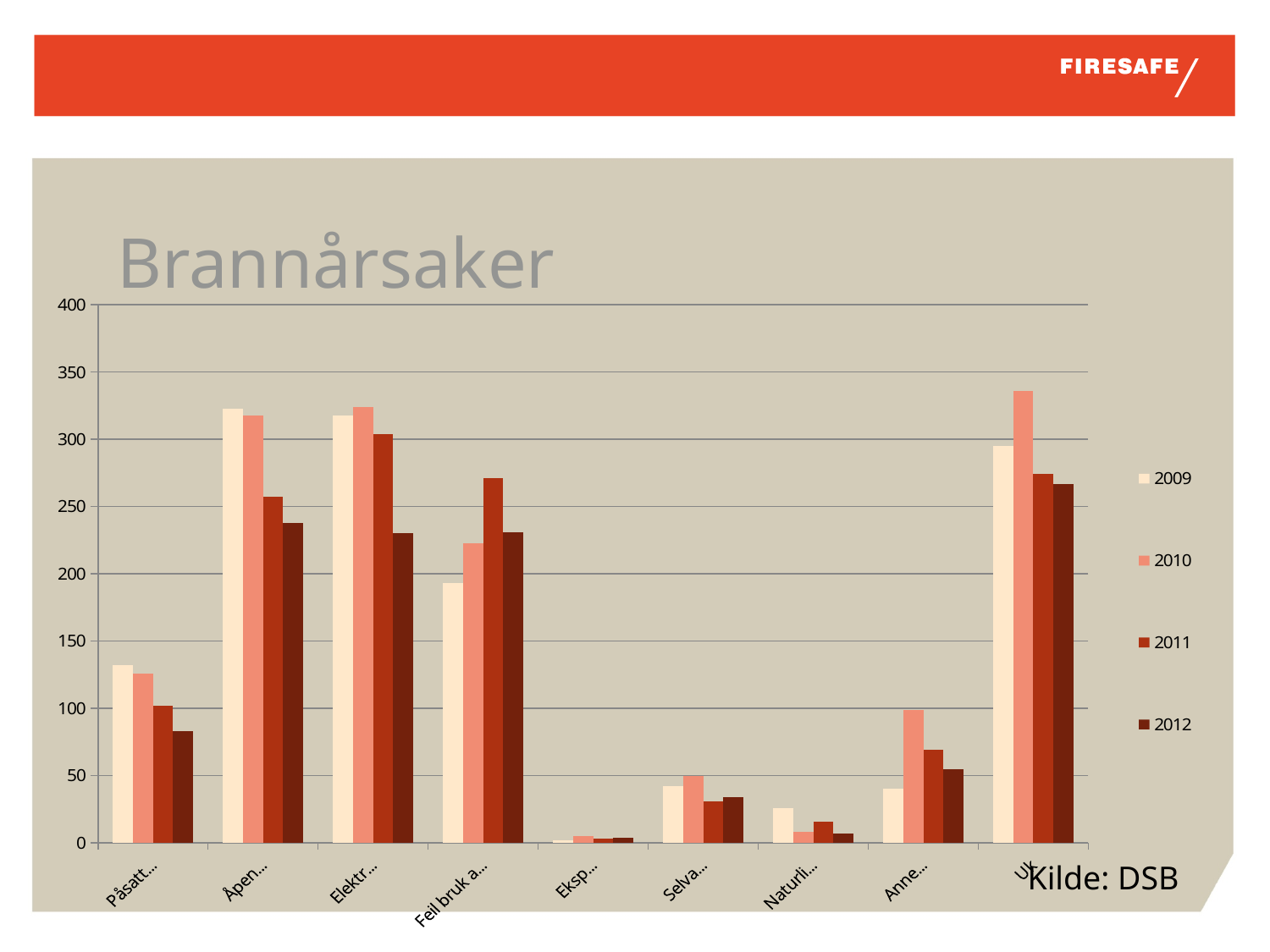
Which year has the lowest value for Påsatt...? 2012 What kind of chart is shown on the slide? bar chart How many series does the legend list? 4 What is the title of the chart? Brannårsaker Is the 2012 value for Åpen... greater or less than 200? greater What source is cited at the bottom right of the chart? Kilde: DSB How many category groups of bars are plotted along the x axis? 9 Is the 2009 value for Påsatt... greater or less than 100? greater Do the values for Påsatt... rise or fall from 2009 to 2012? fall Which year has the highest value for Anne...? 2010 Is the 2010 value for Eksp... greater or less than 50? less For Feil bruk a..., which is larger: the 2009 value or the 2011 value? 2011